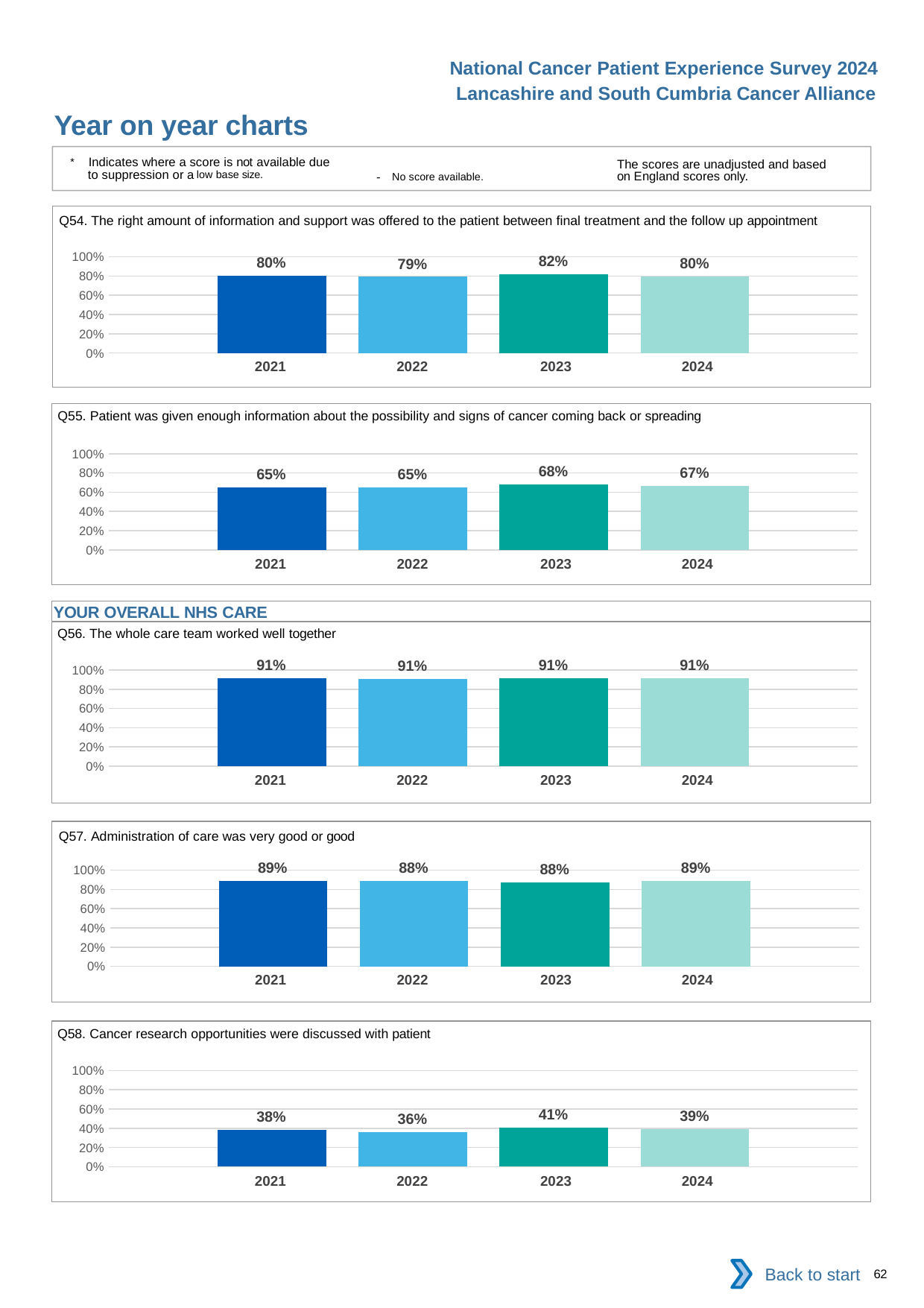
In the Q54 chart, which year has the lowest value? 2022 What type of chart is the Q58 chart? Bar chart In the Q58 chart, which year has the lowest value? 2022 In the Q55 chart, what is the difference between the 2023 and 2021 values? 3% In the Q56 chart, how many years are plotted? 4 In the Q55 chart, what is the value for 2024? 67% In the Q57 chart, what is the value for 2022? 88% In the Q56 chart, what is the value for 2021? 91% In the Q54 chart, what is the value for 2023? 82% In the Q57 chart, is the value for 2023 greater or less than 80%? greater In the Q58 chart, what is the difference between the 2023 and 2022 values? 5% In the Q55 chart, which year has the highest value? 2023